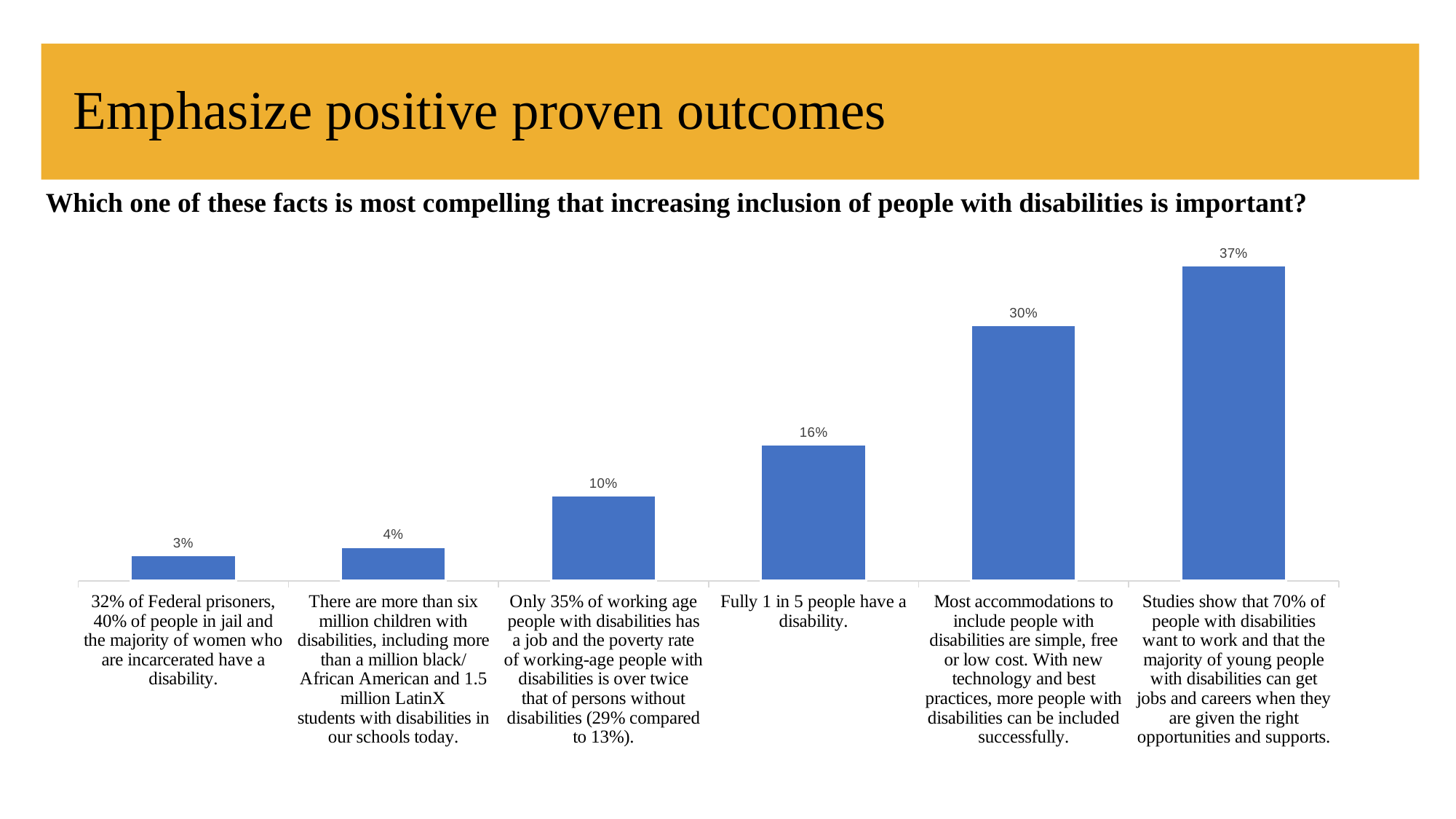
Which fact received the lowest percentage of responses? 32% of Federal prisoners, 40% of people in jail and the majority of women who are incarcerated have a disability. What question is the chart answering, as stated above it? Which one of these facts is most compelling that increasing inclusion of people with disabilities is important? What is the value for the fact about 32% of Federal prisoners, 40% of people in jail and the majority of incarcerated women having a disability? 3% What percentage is shown for the fact that most accommodations to include people with disabilities are simple, free or low cost? 30% Do the values rise or fall moving from left to right across the chart? Rise Which has a larger value: the fact about more than six million children with disabilities, or the fact that only 35% of working age people with disabilities has a job? Only 35% of working age people with disabilities has a job and the poverty rate of working-age people with disabilities is over twice that of persons without disabilities (29% compared to 13%). What percentage of respondents chose the fact that 'Fully 1 in 5 people have a disability' as most compelling? 16% What kind of chart is shown on the slide? Bar chart What is the difference between the value for 'Fully 1 in 5 people have a disability' and the value for the fact about only 35% of working age people with disabilities having a job? 6% What is the difference between the highest value (37%) and the value for the fact about most accommodations being simple, free or low cost (30%)? 7% How many facts (categories) are shown in the chart? 6